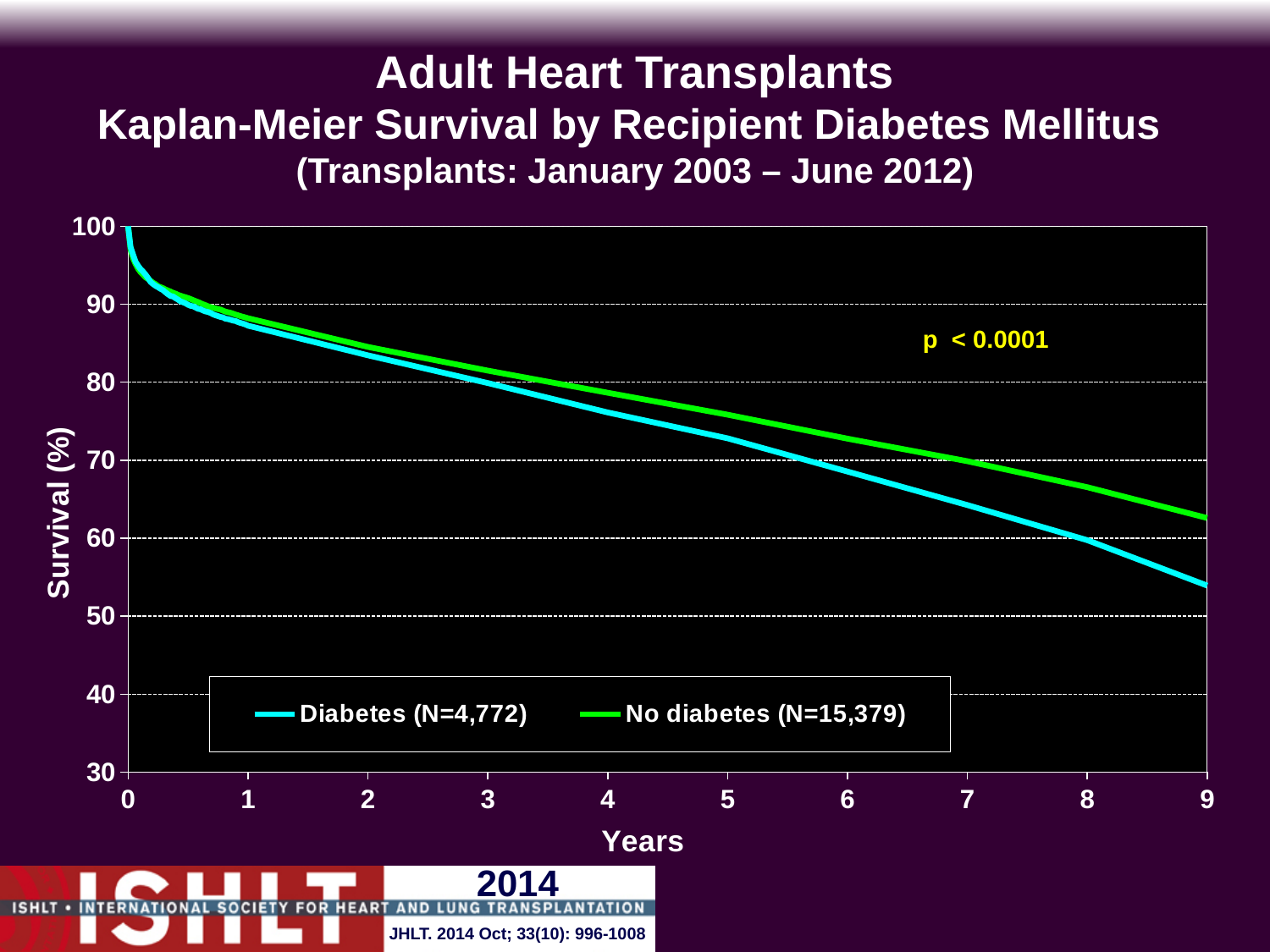
Which series has the higher survival at year 8? No diabetes Is the survival for the No diabetes group at year 9 greater or less than 60? greater Is the survival for the Diabetes group at year 9 greater or less than 60? less Is the survival for the No diabetes group at year 2 greater or less than 80? greater What kind of chart is shown on the slide? Line chart What p-value is shown on the chart? p < 0.0001 What is the N for the Diabetes group shown in the legend? 4,772 Do the survival curves rise or fall as years increase? Fall How many series does the legend list? 2